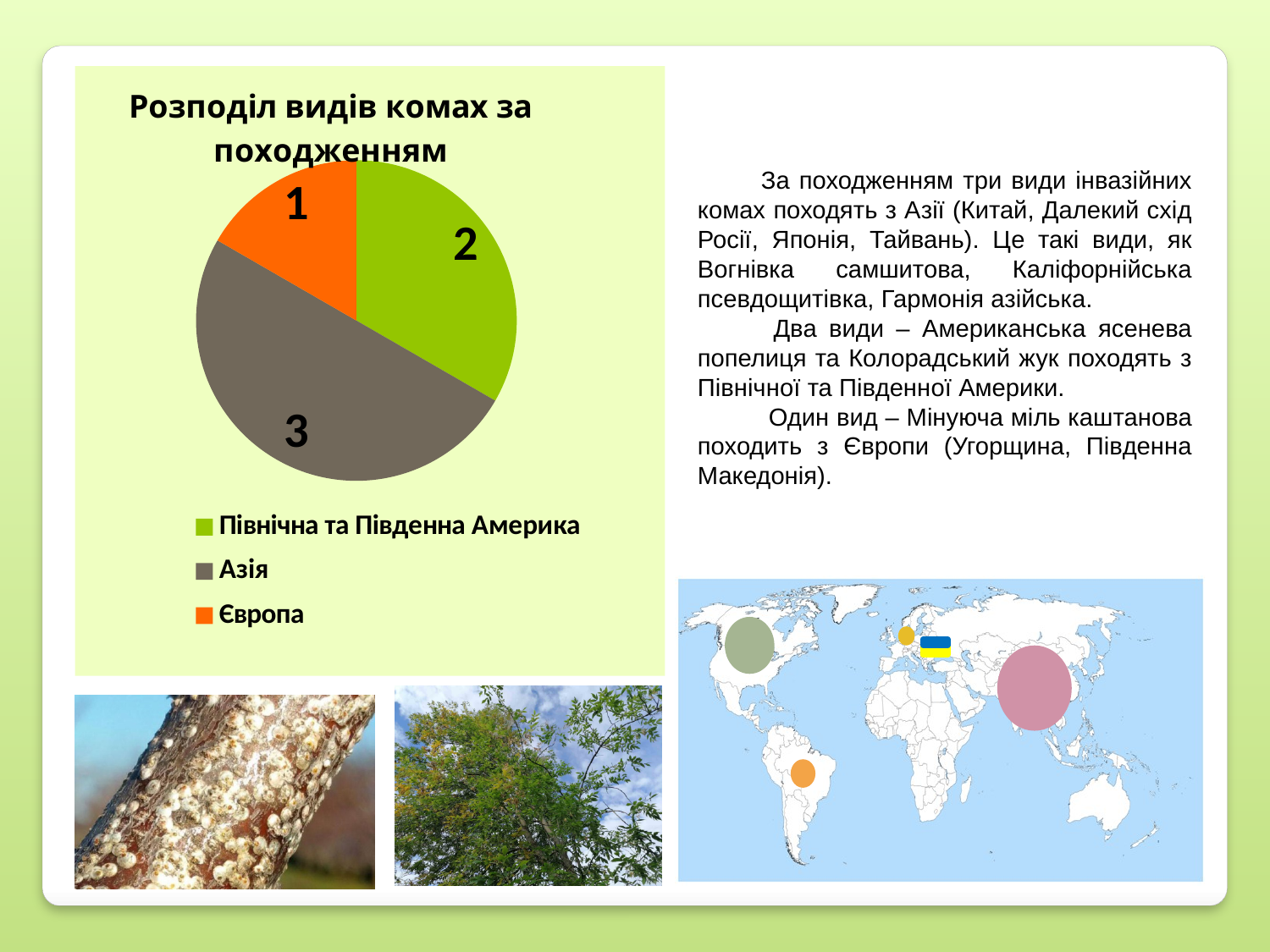
Which category has the smallest slice of the pie? Європа What share of the pie does Азія represent? 50% How many slices does the pie chart have? 3 Which category has the largest slice of the pie? Азія What is the difference between the values for Азія and Європа? 2 What is the title of the chart? Розподіл видів комах за походженням What is the value for Європа? 1 What is the value for Азія in the pie chart? 3 Which is larger, the value for Азія or the value for Північна та Південна Америка? Азія What kind of chart is shown on the slide? pie chart What is the value for Північна та Південна Америка? 2 How many entries does the legend list? 3